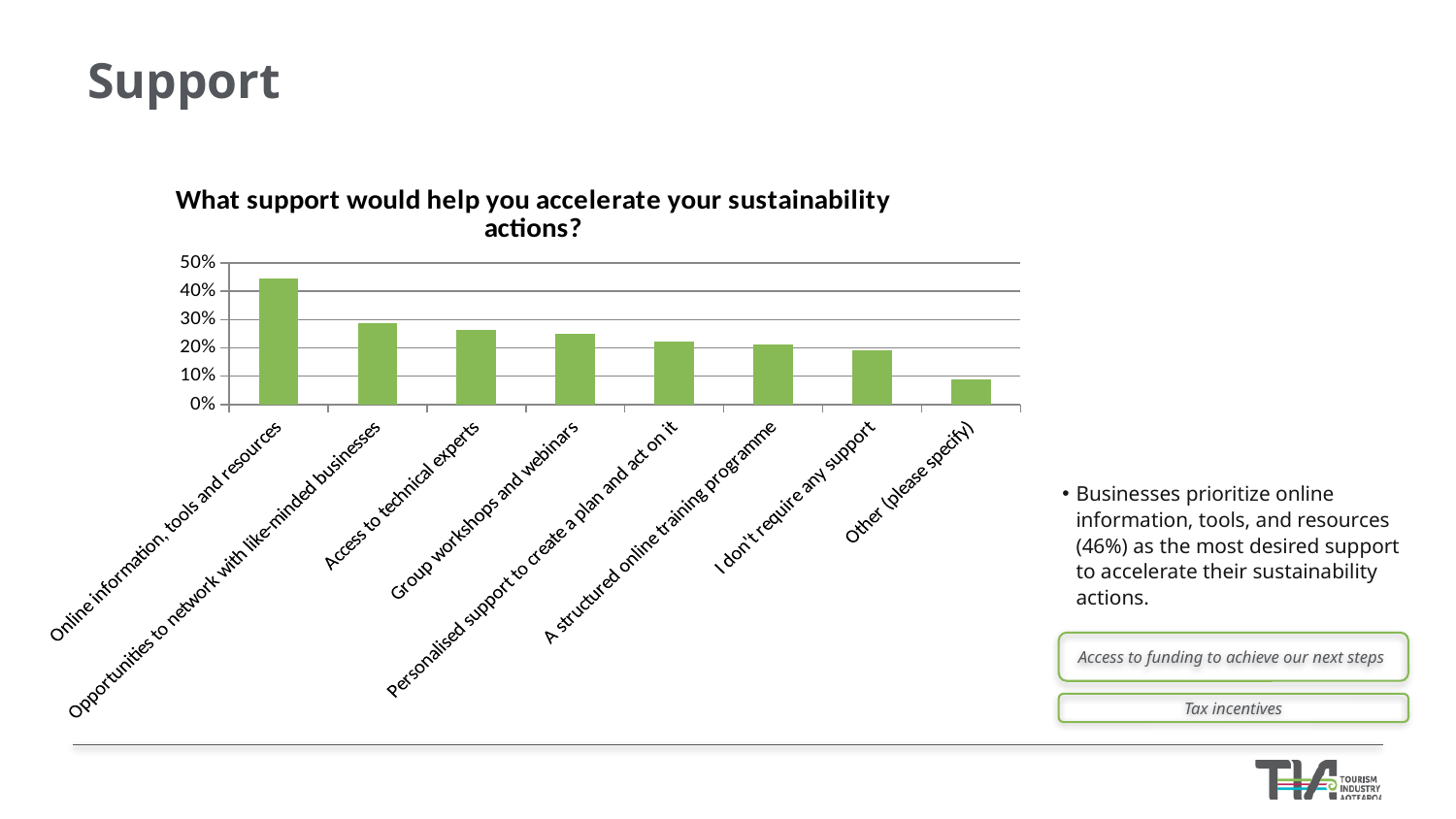
What kind of chart is shown on the slide? Bar chart Is the value for Group workshops and webinars greater or less than 30%? less Do the bar values rise or fall from left to right along the x axis? Fall Is the value for Online information, tools and resources greater or less than 40%? greater Which is larger: the value for Online information, tools and resources or the value for Opportunities to network with like-minded businesses? Online information, tools and resources Which category has the highest value in the chart? Online information, tools and resources Is the value for Other (please specify) greater or less than 10%? less How many categories are shown on the x axis of the chart? 8 Which category has the lowest value in the chart? Other (please specify) Which is larger: the value for I don't require any support or the value for Other (please specify)? I don't require any support What is the title of the chart? What support would help you accelerate your sustainability actions?